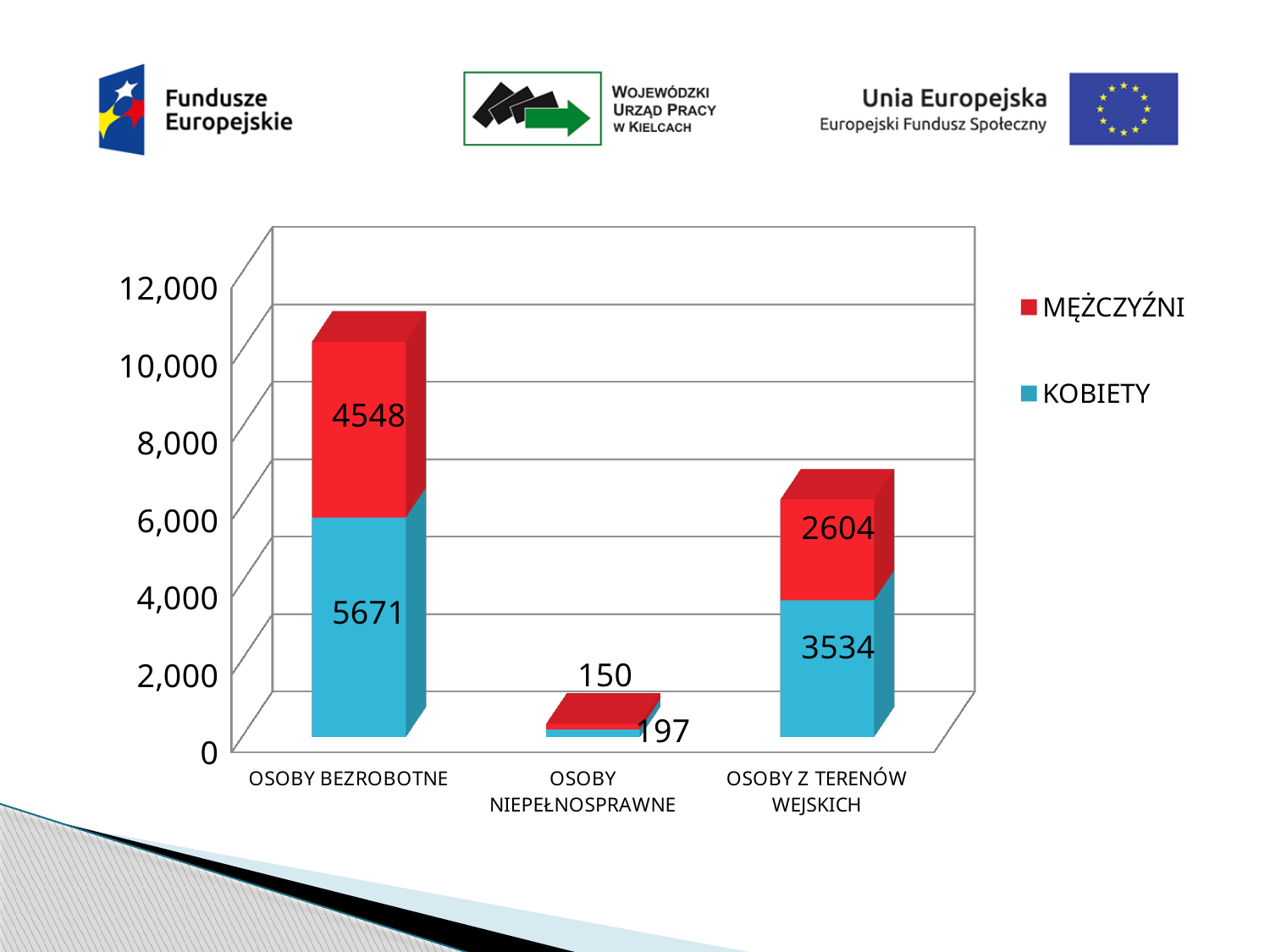
Which category has the tallest stacked bar? OSOBY BEZROBOTNE How many series does the legend list? 2 Which series is shown in red in the legend? MĘŻCZYŹNI What is the MĘŻCZYŹNI value for OSOBY Z TERENÓW WEJSKICH? 2604 How many categories are shown on the x axis? 3 What is the total of the stacked bar for OSOBY BEZROBOTNE? 10219 What is the KOBIETY value for OSOBY Z TERENÓW WEJSKICH? 3534 What is the difference between the KOBIETY and MĘŻCZYŹNI values for OSOBY Z TERENÓW WEJSKICH? 930 What is the MĘŻCZYŹNI value for OSOBY BEZROBOTNE? 4548 What is the KOBIETY value for OSOBY BEZROBOTNE? 5671 What kind of chart is shown on the slide? Stacked bar chart Which category has the shortest stacked bar? OSOBY NIEPEŁNOSPRAWNE